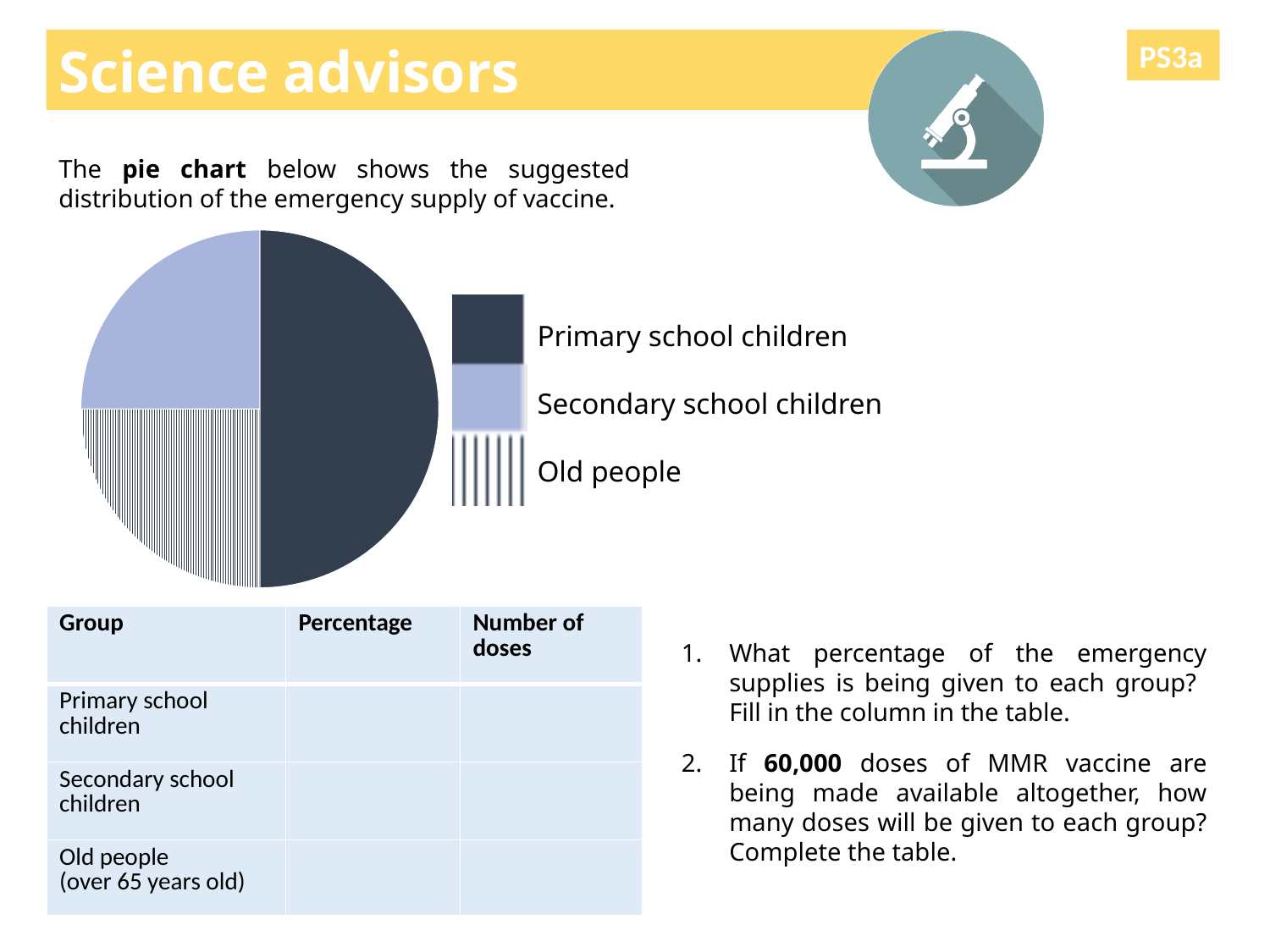
Which slice is larger: Old people or Primary school children? Primary school children How many entries does the legend of the pie chart list? 3 Which slice is larger: Primary school children or Secondary school children? Primary school children Which group is represented by the striped slice in the pie chart? Old people Which group is represented by the dark navy slice in the pie chart? Primary school children How many groups (slices) does the pie chart show? 3 What kind of chart is shown on the slide? pie chart Which group has the largest slice of the pie chart? Primary school children According to the slide text, what does the pie chart show the suggested distribution of? the emergency supply of vaccine